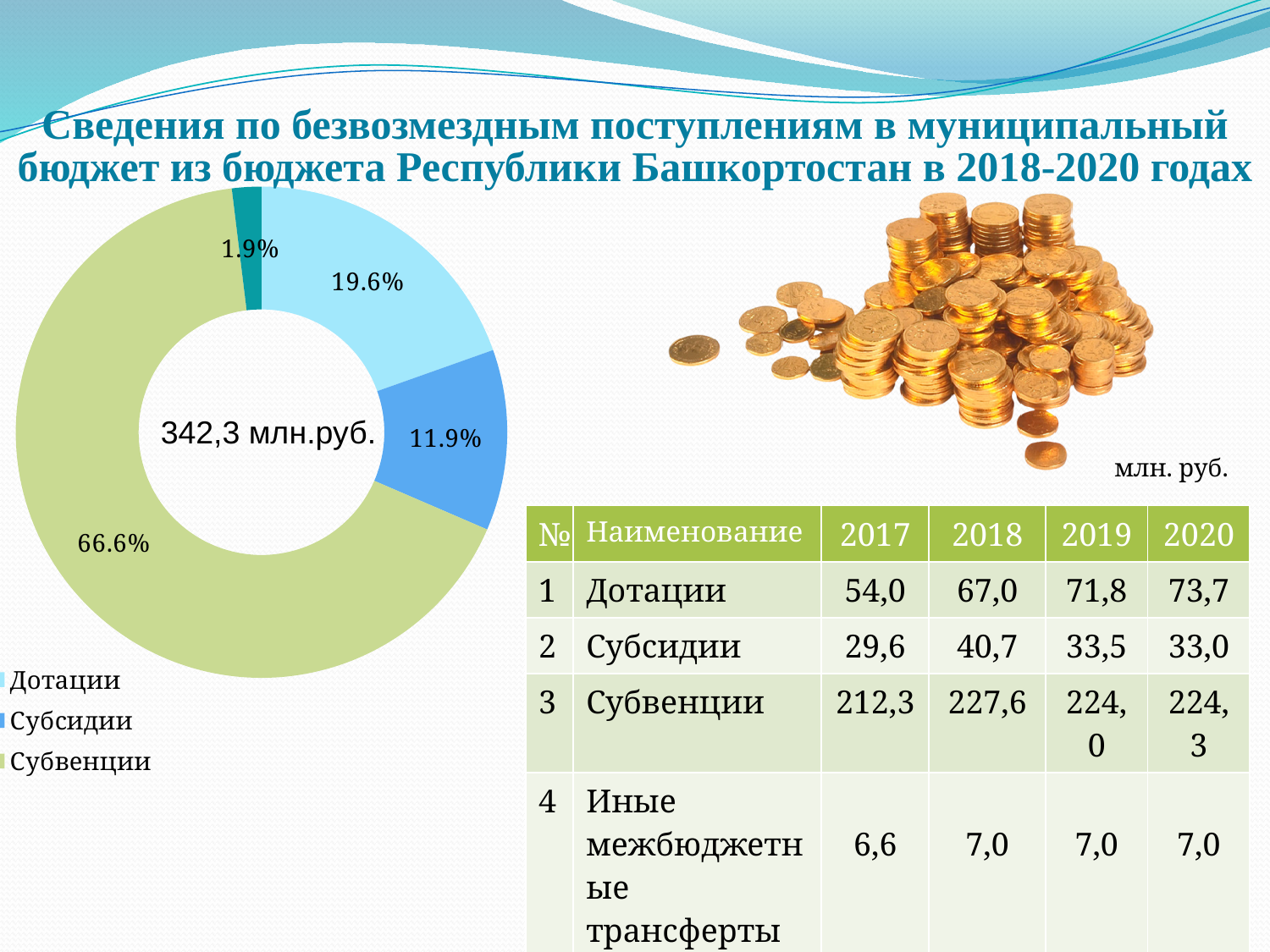
What is the percentage shown on the smallest slice of the doughnut chart? 1.9% What share of the doughnut chart does Дотации account for? 19.6% Which slice is larger in the doughnut chart, Дотации or Субсидии? Дотации How many entries does the legend of the doughnut chart list? 3 What share of the doughnut chart does Субсидии account for? 11.9% What kind of chart is shown on the left of the slide? Doughnut (pie) chart By how many percentage points does the Субвенции share exceed the Дотации share in the doughnut chart? 47.0 percentage points Which category has the largest slice in the doughnut chart? Субвенции What colour is the Субвенции slice in the doughnut chart? Light green What total value is printed in the centre of the doughnut chart? 342,3 млн.руб. What share of the doughnut chart does Субвенции account for? 66.6% How many slices does the doughnut chart have? 4